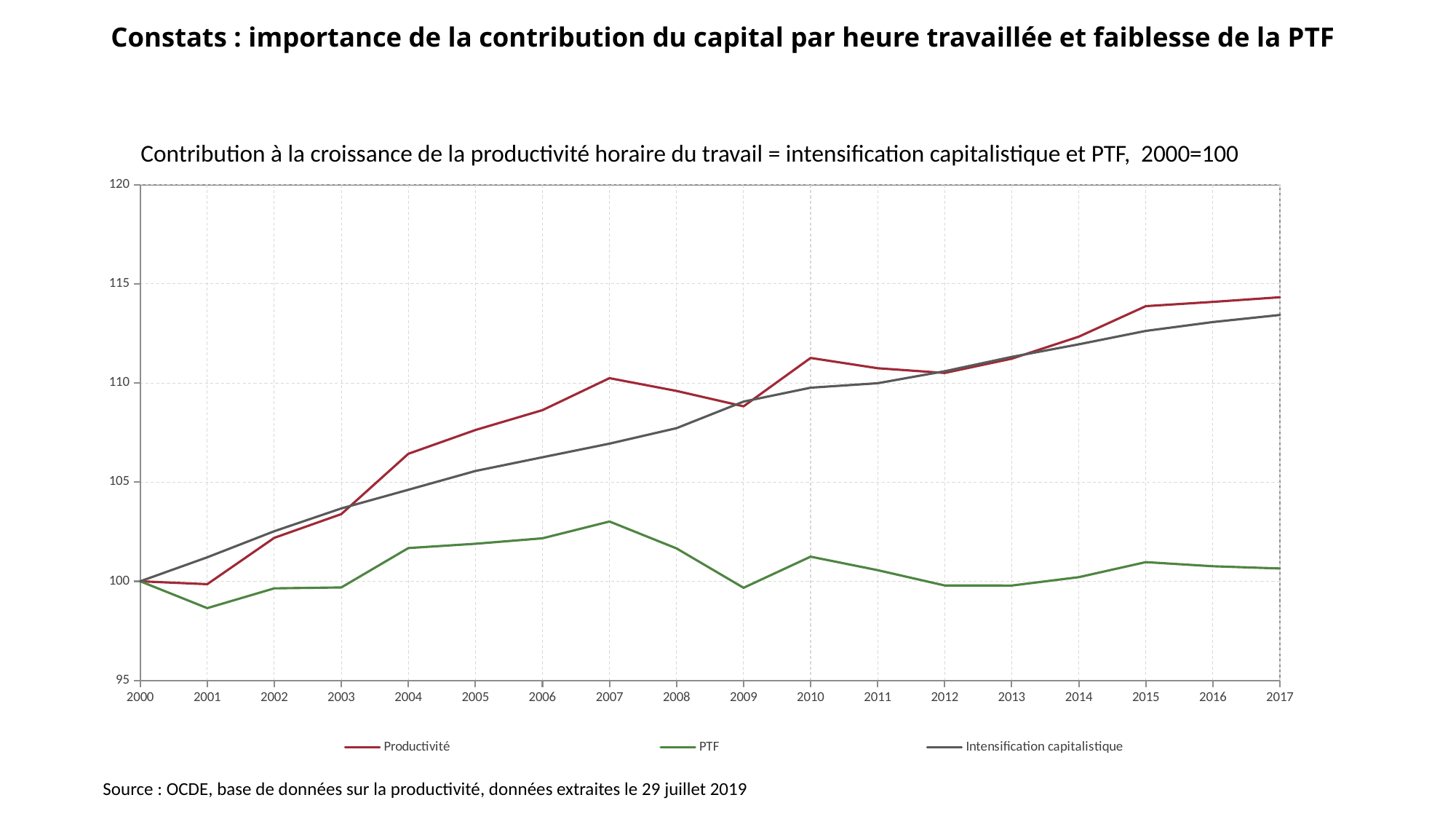
Which series has the lowest value in 2017? PTF In which year does the PTF series reach its highest value? 2007 In 2007, which is higher: Productivité or Intensification capitalistique? Productivité Is the value for Productivité in 2017 greater or less than 110? greater In which year does the PTF series reach its lowest value? 2001 What is the value of Productivité in 2000? 100 How many series does the legend list? 3 Does the Intensification capitalistique series rise or fall from 2000 to 2017? rise Is the value for Intensification capitalistique in 2008 greater or less than 105? greater How many years are plotted along the x axis? 18 What kind of chart is shown on the slide? line chart Is the value for PTF in 2007 greater or less than 105? less